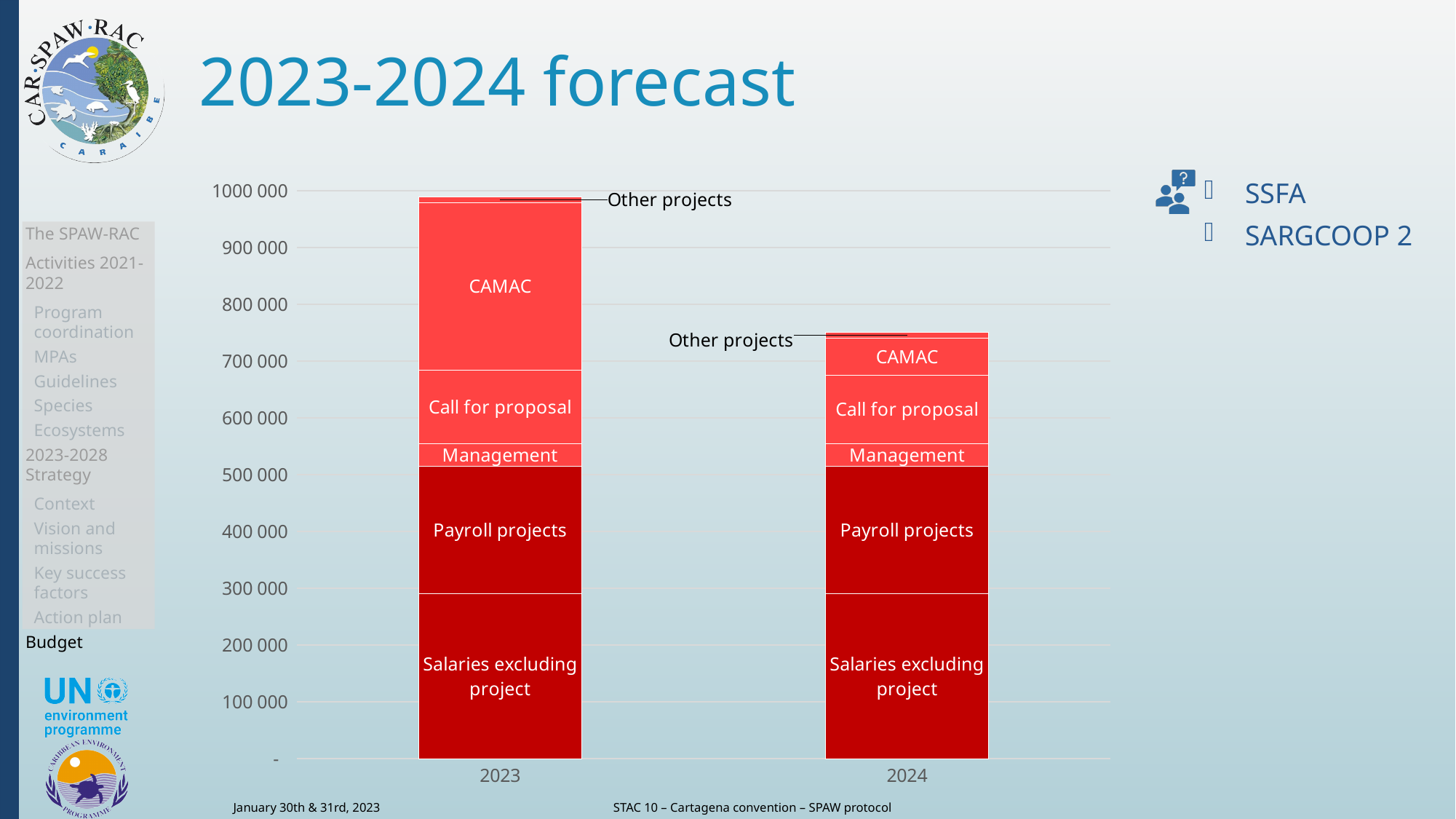
What is the title of the slide containing the chart? 2023-2024 forecast Which segment is the smallest in the 2023 bar? Other projects Is the total of the 2023 bar greater or less than 900 000? greater How many labelled segments make up each stacked bar in the chart? 6 Which year has the taller stacked bar, 2023 or 2024? 2023 Does the total forecast rise or fall from 2023 to 2024? fall Is the total of the 2024 bar greater or less than 800 000? less How many years (categories) are shown on the x axis of the chart? 2 Is the CAMAC segment larger in 2023 or in 2024? 2023 What kind of chart is shown on the slide? stacked bar chart Which segment is the largest in the 2024 bar? Salaries excluding project Is the top of the Management segment in the 2023 bar greater or less than 600 000? less